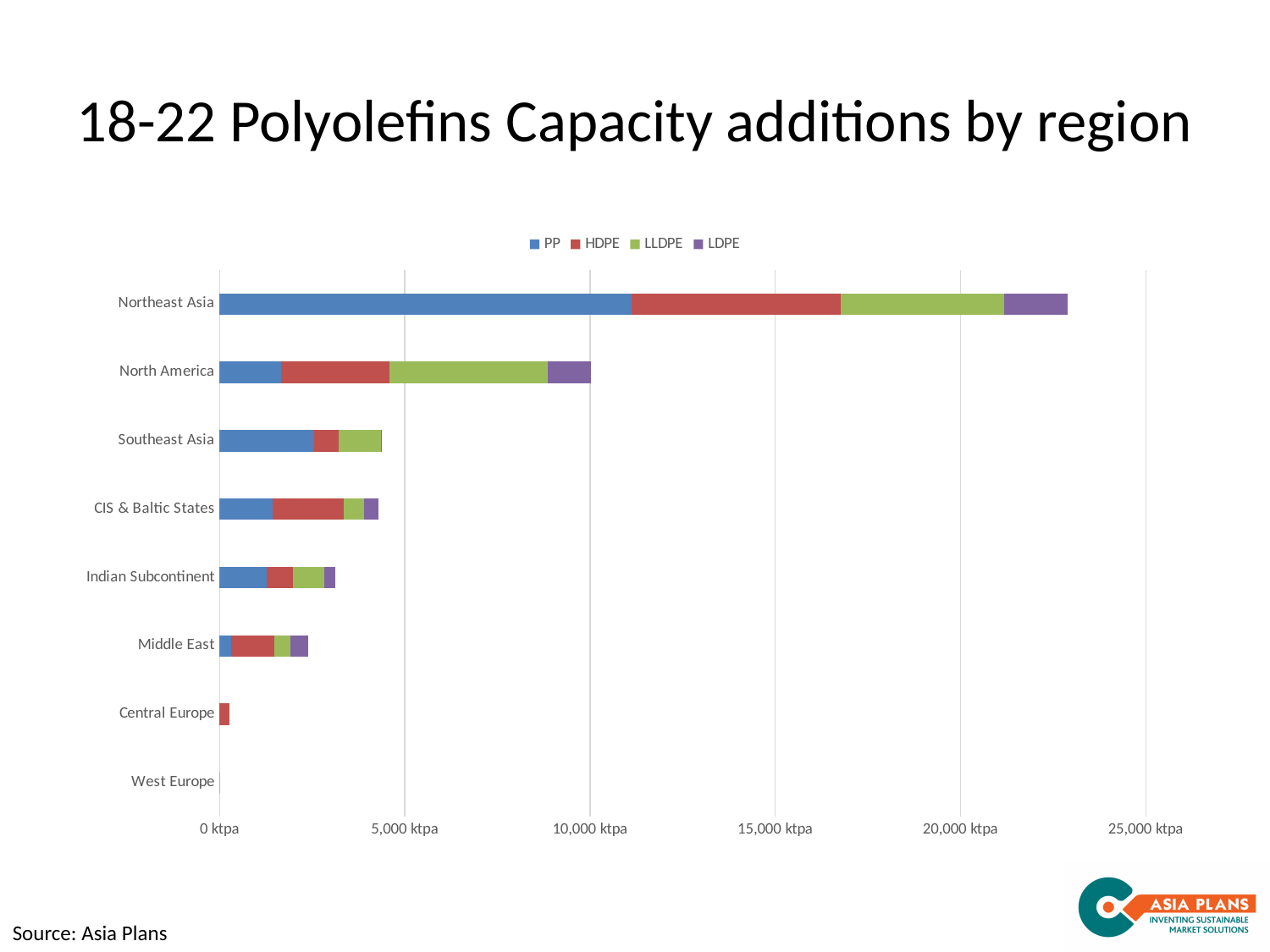
What is the title of the chart? 18-22 Polyolefins Capacity additions by region Which region has a larger total capacity addition, Indian Subcontinent or Middle East? Indian Subcontinent How many series does the legend list? 4 Is the total value for Northeast Asia greater or less than 20,000 ktpa? greater Which region has the smallest total capacity addition? West Europe What kind of chart is shown on the slide? Stacked bar chart Is the total value for Central Europe greater or less than 5,000 ktpa? less Which region has the largest total capacity addition? Northeast Asia Which region has a larger total capacity addition, Northeast Asia or North America? Northeast Asia Is the total value for Southeast Asia greater or less than 5,000 ktpa? less How many regions are listed on the chart? 8